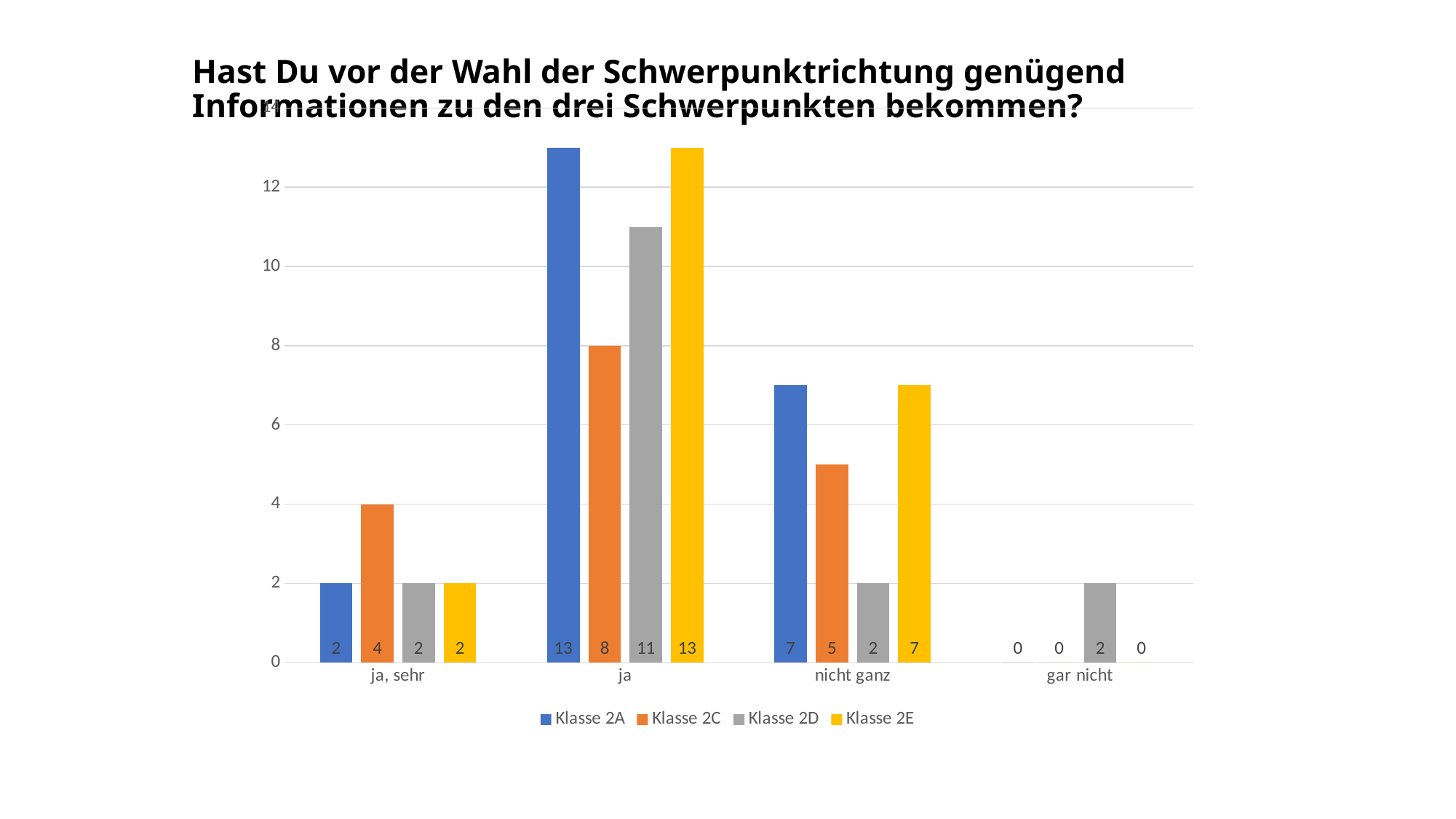
What is the value for Klasse 2D in the "gar nicht" category? 2 How many categories are shown on the x axis? 4 Which category has the highest value for Klasse 2A? ja Which is larger in the "ja" category: Klasse 2C or Klasse 2D? Klasse 2D What is the value for Klasse 2E in the "nicht ganz" category? 7 Which colour represents Klasse 2E in the chart? Yellow What is the difference between Klasse 2A and Klasse 2C in the "nicht ganz" category? 2 Which series has the lowest value in the "ja" category? Klasse 2C What is the value for Klasse 2D in the "ja" category? 11 What is the value for Klasse 2C in the "ja, sehr" category? 4 What kind of chart is shown on the slide? Bar chart How many series does the legend list? 4